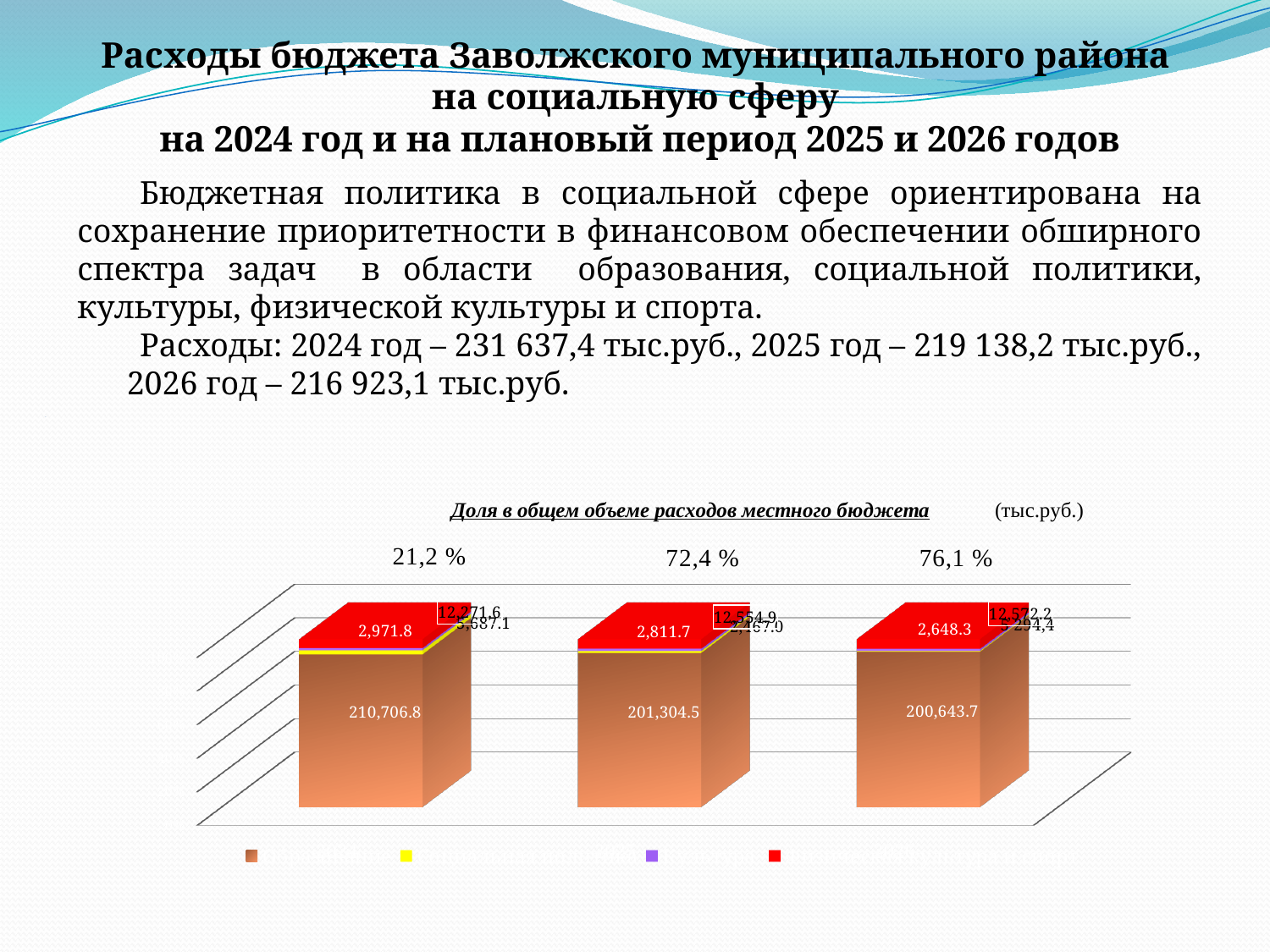
What kind of chart is shown on the slide? bar chart Which is larger, the red segment of the leftmost bar or the red segment of the rightmost bar? the rightmost bar How many series does the chart legend list? 4 What is the value of the large orange segment of the leftmost bar? 210,706.8 How many bars are plotted in the chart? 3 What is the value of the large orange segment of the rightmost bar? 200,643.7 Which bar has the largest orange segment? the leftmost bar What is the value of the red segment of the rightmost bar? 12,572.2 What percentage is printed above the middle bar? 72,4 % What is the value of the large orange segment of the middle bar? 201,304.5 What is the difference between the orange segments of the leftmost bar and the middle bar? 9,402.3 What is the value of the red segment of the leftmost bar? 12,271.6